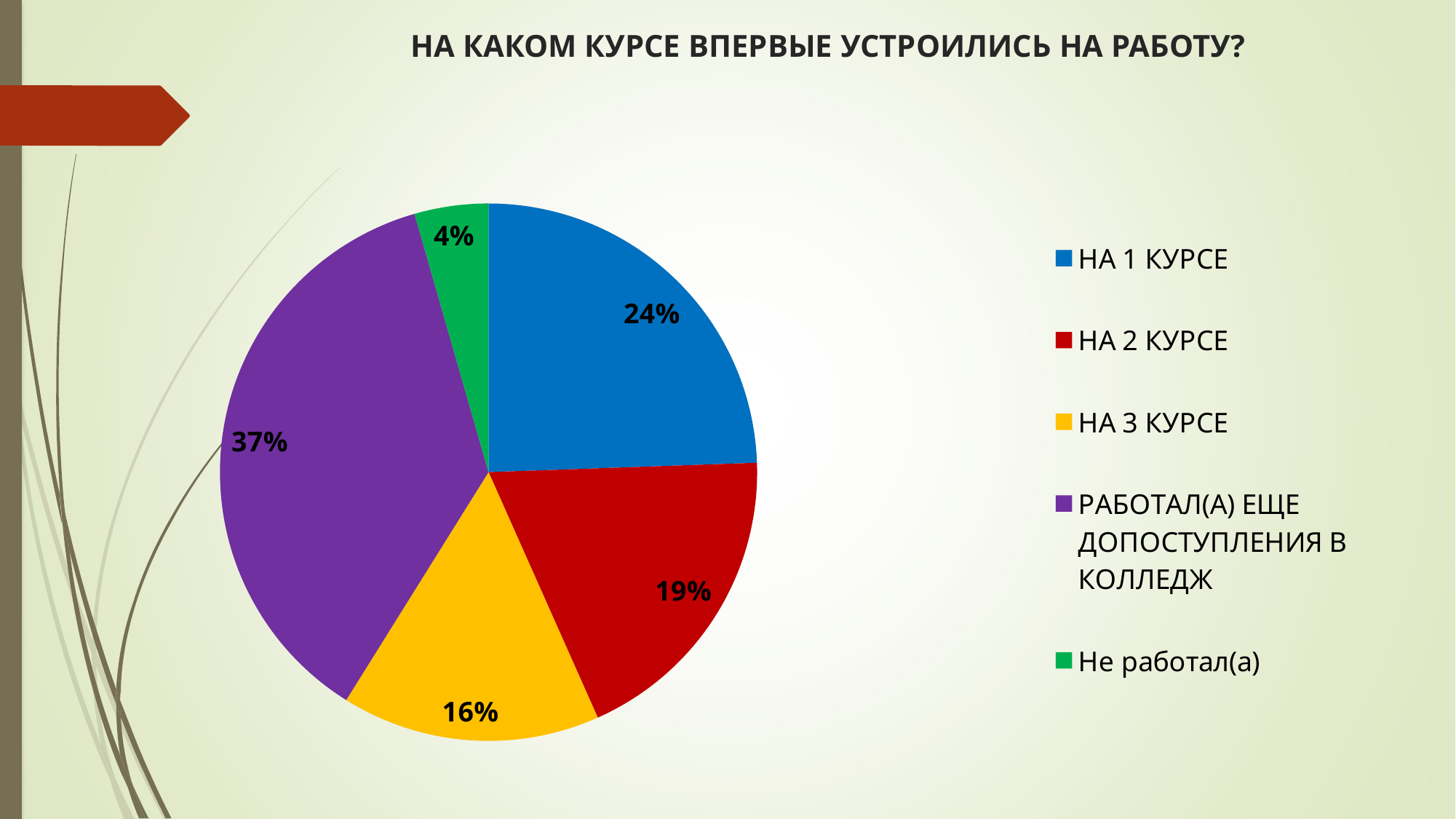
What share of the pie does "НА 1 КУРСЕ" have? 24% What is the difference in percentage points between "НА 1 КУРСЕ" and "НА 3 КУРСЕ"? 8 Which category has the largest slice of the pie? РАБОТАЛ(А) ЕЩЕ ДОПОСТУПЛЕНИЯ В КОЛЛЕДЖ How many categories does the legend list? 5 What share of the pie does "НА 3 КУРСЕ" have? 16% What is the title of the chart? НА КАКОМ КУРСЕ ВПЕРВЫЕ УСТРОИЛИСЬ НА РАБОТУ? What share of the pie does "НА 2 КУРСЕ" have? 19% What type of chart is shown on the slide? pie chart Which is larger, the slice for "НА 2 КУРСЕ" or the slice for "НА 3 КУРСЕ"? НА 2 КУРСЕ Which category has the smallest slice of the pie? Не работал(а)